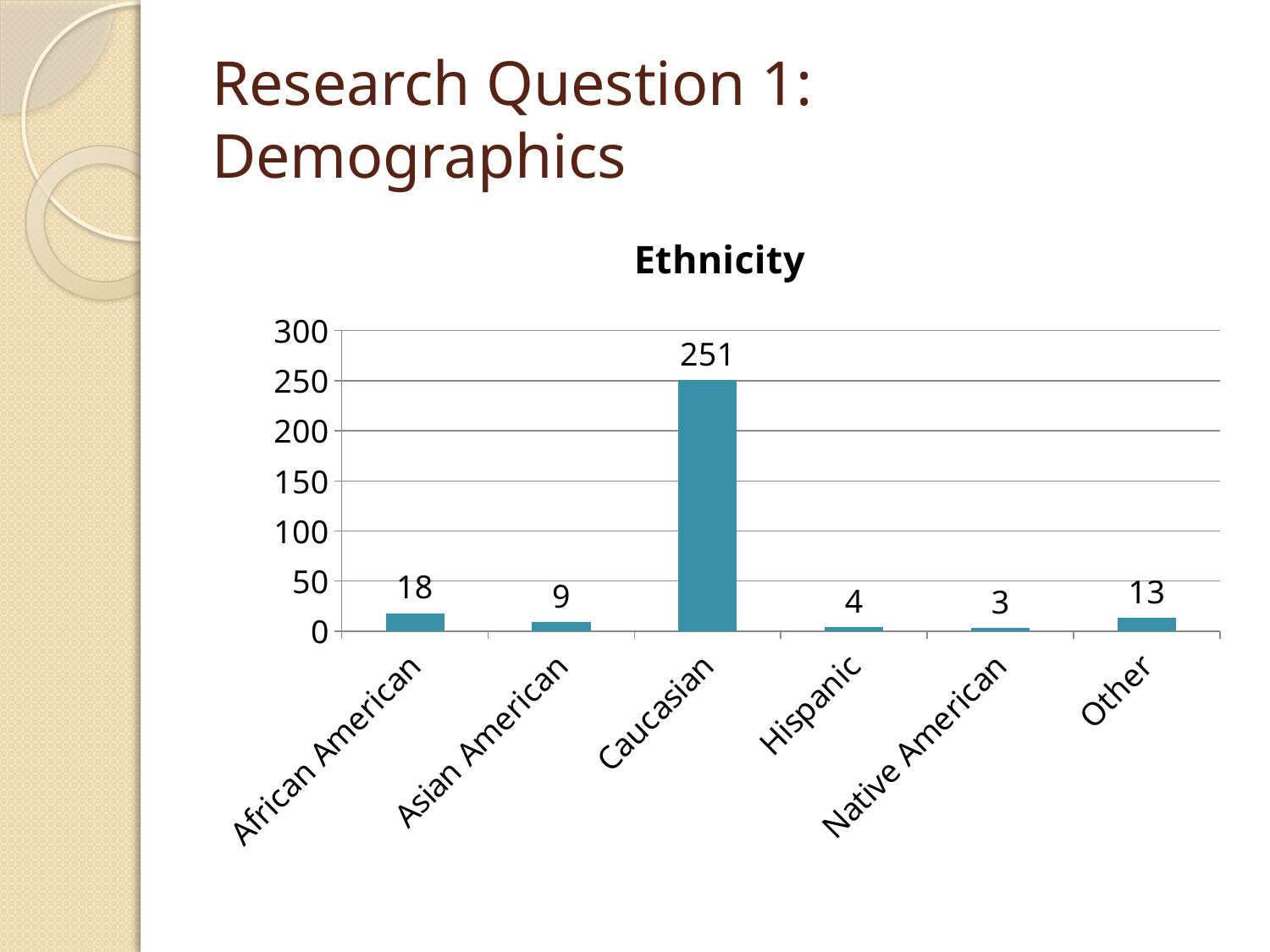
What is the difference between the values for Other and Hispanic? 9 What is the difference between the values for African American and Asian American? 9 What is the value for Other in the Ethnicity chart? 13 Is the value for Caucasian greater or less than 200? greater Which is larger, the value for Asian American or the value for Other? Other What is the value for Native American in the Ethnicity chart? 3 What is the value for Caucasian in the Ethnicity chart? 251 What is the value for African American in the Ethnicity chart? 18 What kind of chart is shown on the slide? Bar chart Which category has the highest value in the Ethnicity chart? Caucasian Which category has the lowest value in the Ethnicity chart? Native American How many categories are shown in the Ethnicity chart? 6